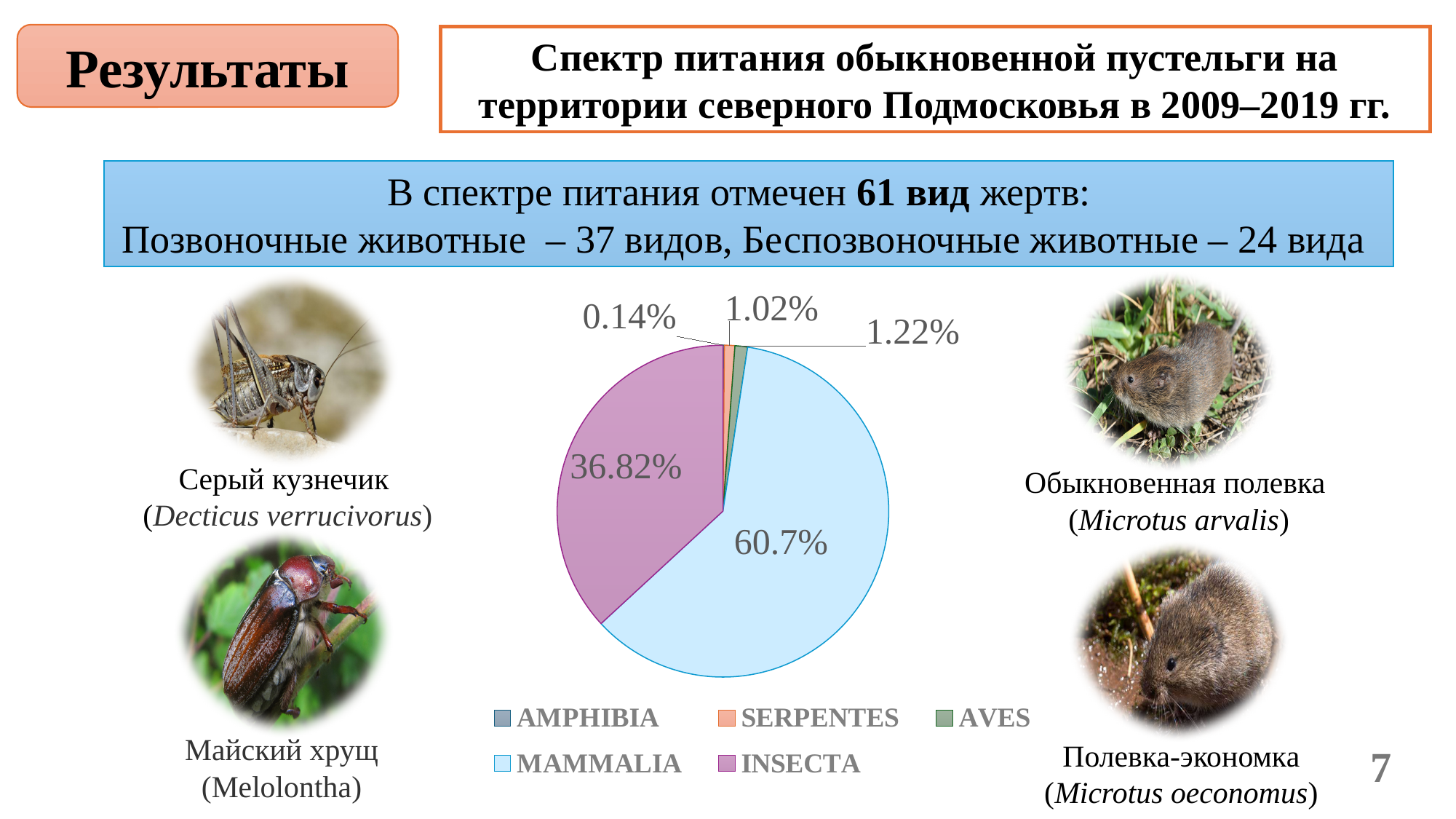
What share of the pie chart does AVES account for? 1.22% Which category has the smallest slice in the pie chart? AMPHIBIA What colour is the INSECTA slice in the pie chart? purple Which is larger in the pie chart, INSECTA or MAMMALIA? MAMMALIA What is the value of the smallest slice in the pie chart? 0.14% What share of the pie chart does SERPENTES account for? 1.02% What kind of chart is shown on the slide? pie chart What share of the pie chart does MAMMALIA account for? 60.7% What share of the pie chart does INSECTA account for? 36.82% By how many percentage points does the MAMMALIA share exceed the INSECTA share? 23.88% Which category has the largest slice in the pie chart? MAMMALIA How many categories does the legend of the pie chart list? 5